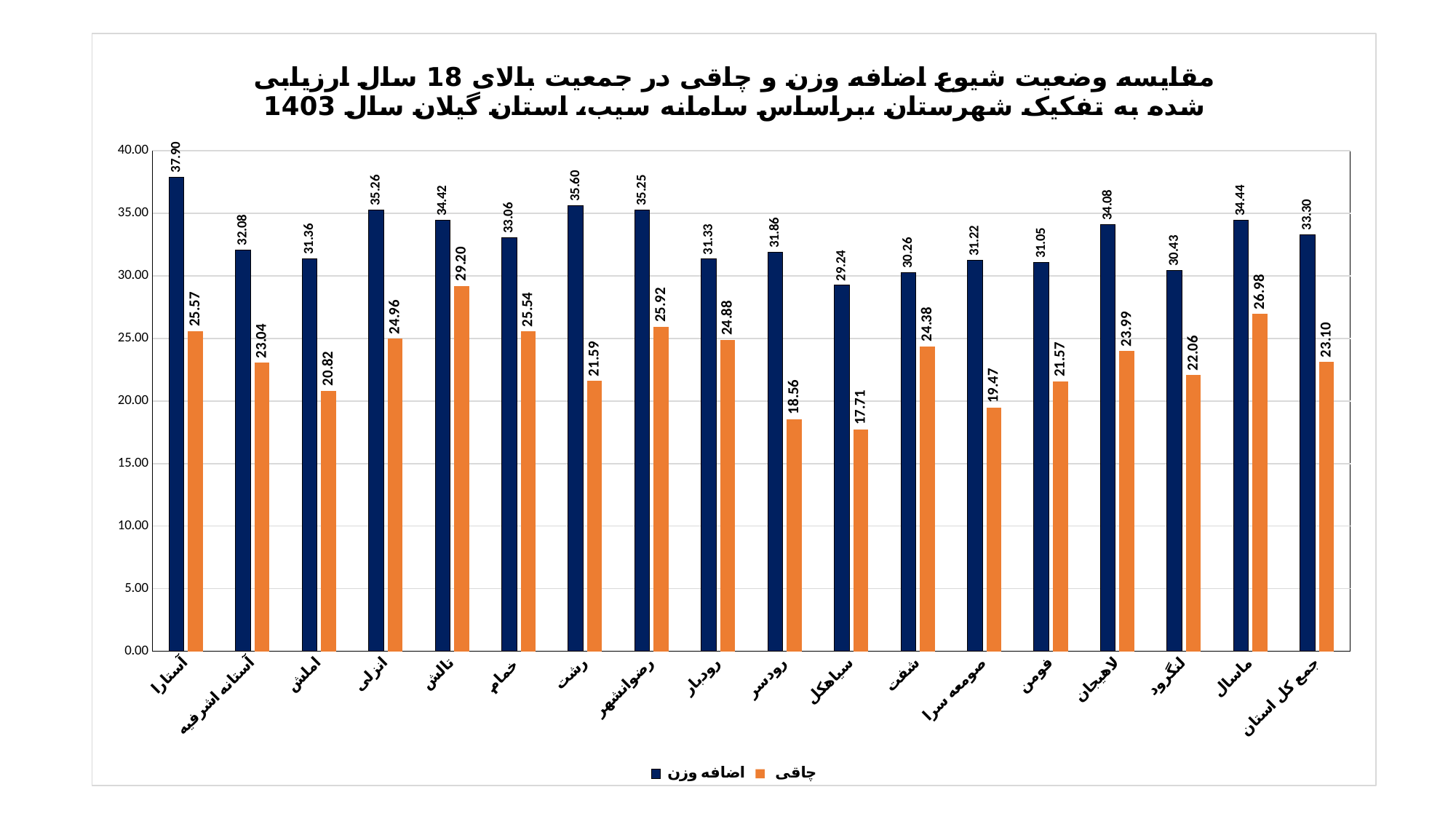
Which category has the lowest value for چاقی? سیاهکل What type of chart is shown on the slide? bar chart What is the value of اضافه وزن for آستارا? 37.90 How many series does the legend list? 2 Which category has the highest value for چاقی? تالش What is the value of چاقی for تالش? 29.20 What is the difference between the اضافه وزن and چاقی values for رشت? 14.01 Which category has the highest value for اضافه وزن? آستارا How many categories are shown on the x axis? 18 Which is larger, the چاقی value for ماسال or the چاقی value for لاهیجان? ماسال Which series is shown in orange in the legend? چاقی What is the value of چاقی for جمع کل استان? 23.10